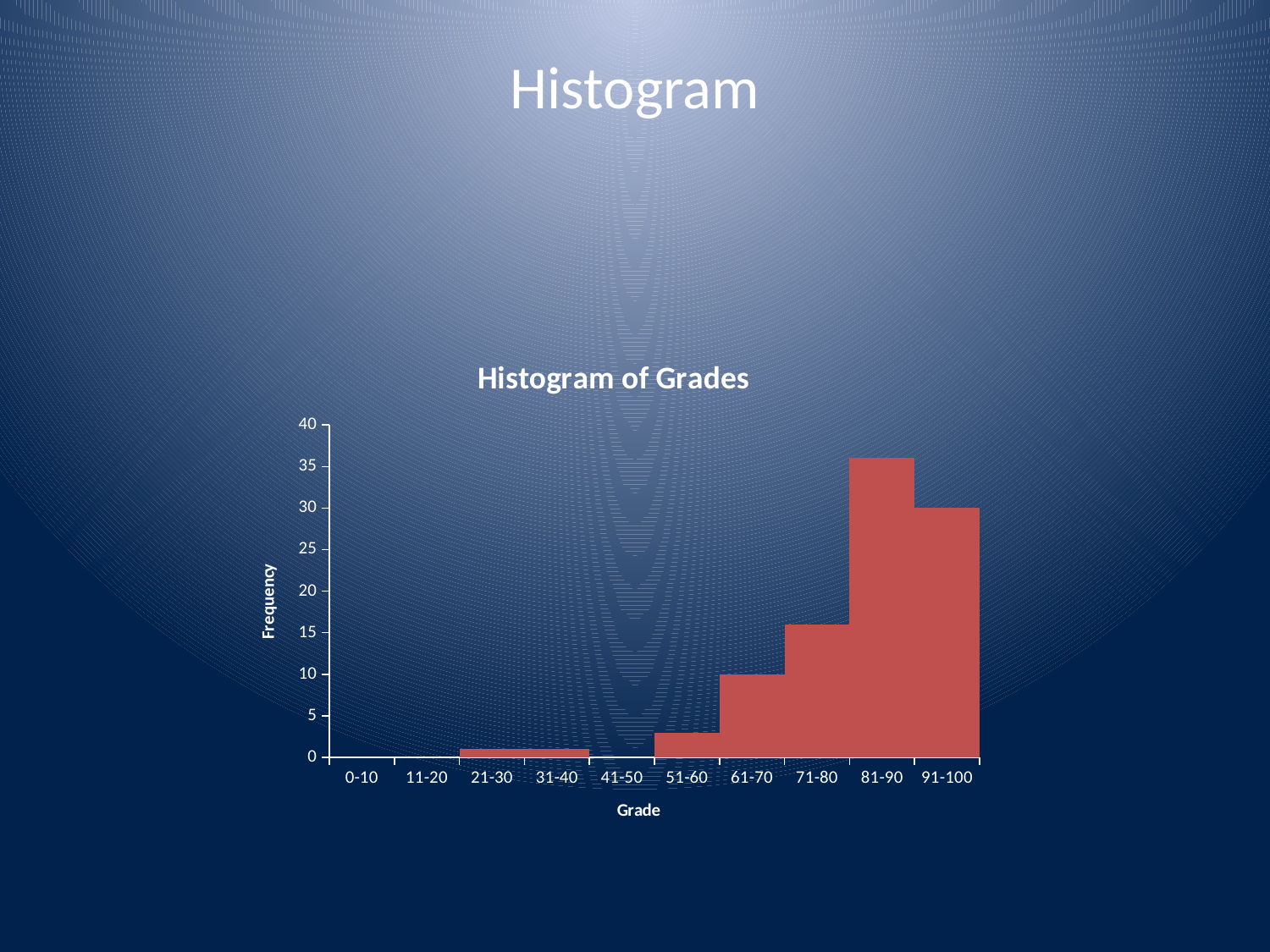
Which grade range has the highest frequency? 81-90 Do the frequencies rise or fall from the 51-60 range to the 81-90 range? rise Which has a higher frequency, the 81-90 range or the 91-100 range? 81-90 What is the frequency for the 91-100 grade range? 30 What is the title of the chart? Histogram of Grades What type of chart is shown on the slide? bar chart Is the frequency for the 71-80 grade range greater or less than 20? less Is the frequency for the 51-60 grade range greater or less than 5? less What is the frequency for the 61-70 grade range? 10 What is the label on the vertical axis of the chart? Frequency How many grade categories are shown on the x axis? 10